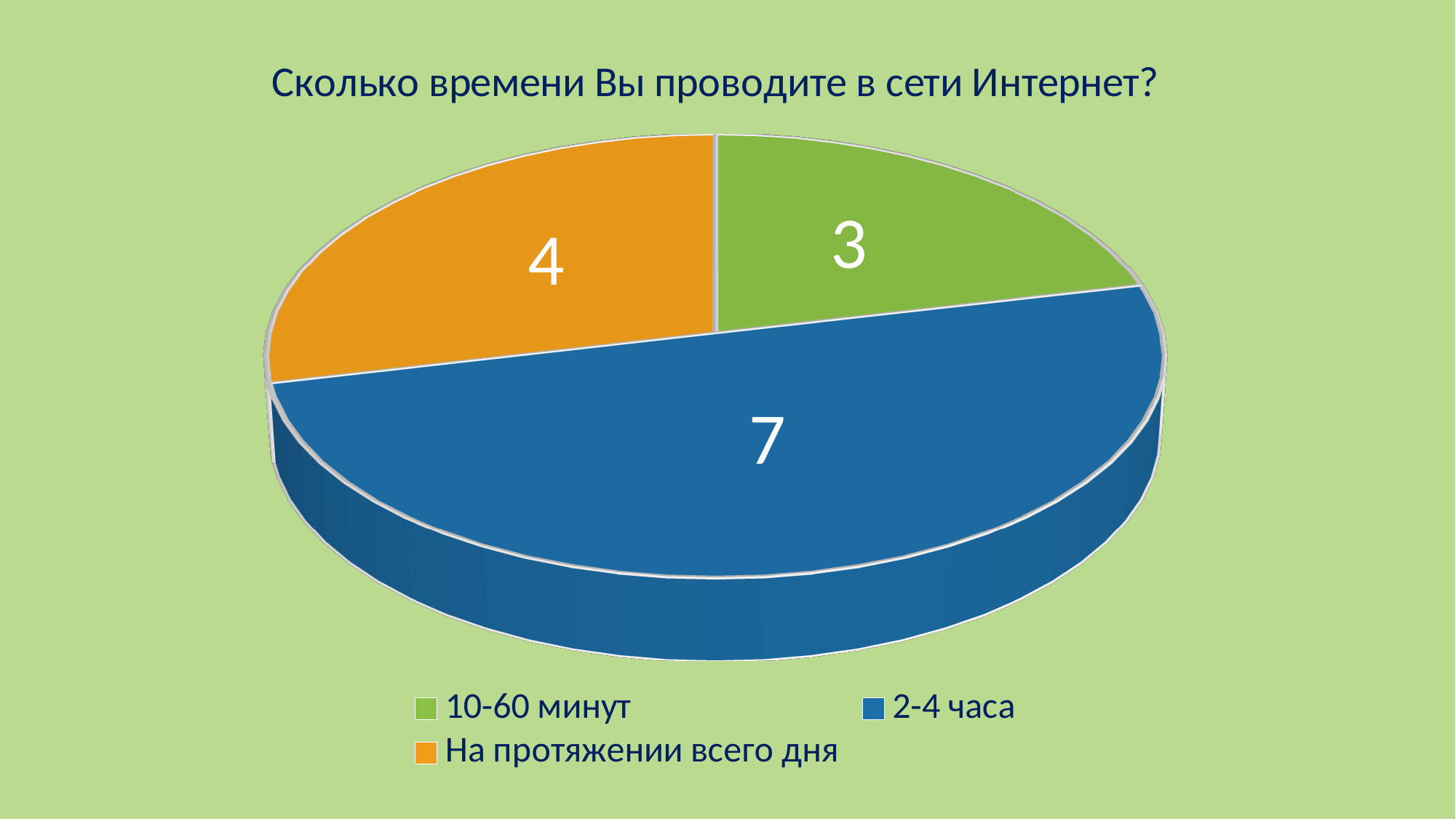
What is the value for the "На протяжении всего дня" slice? 4 What is the total of all slices in the pie chart? 14 What is the difference between the values for "2-4 часа" and "10-60 минут"? 4 Which category has the smallest slice? 10-60 минут What is the title of the chart? Сколько времени Вы проводите в сети Интернет? How many slices does the pie chart have? 3 What kind of chart is shown on the slide? Pie chart Which category has the largest slice? 2-4 часа What is the value for the "10-60 минут" slice? 3 What share of the pie does the "2-4 часа" slice represent? 50% Which is larger, the value for "На протяжении всего дня" or the value for "10-60 минут"? На протяжении всего дня What is the value for the "2-4 часа" slice? 7